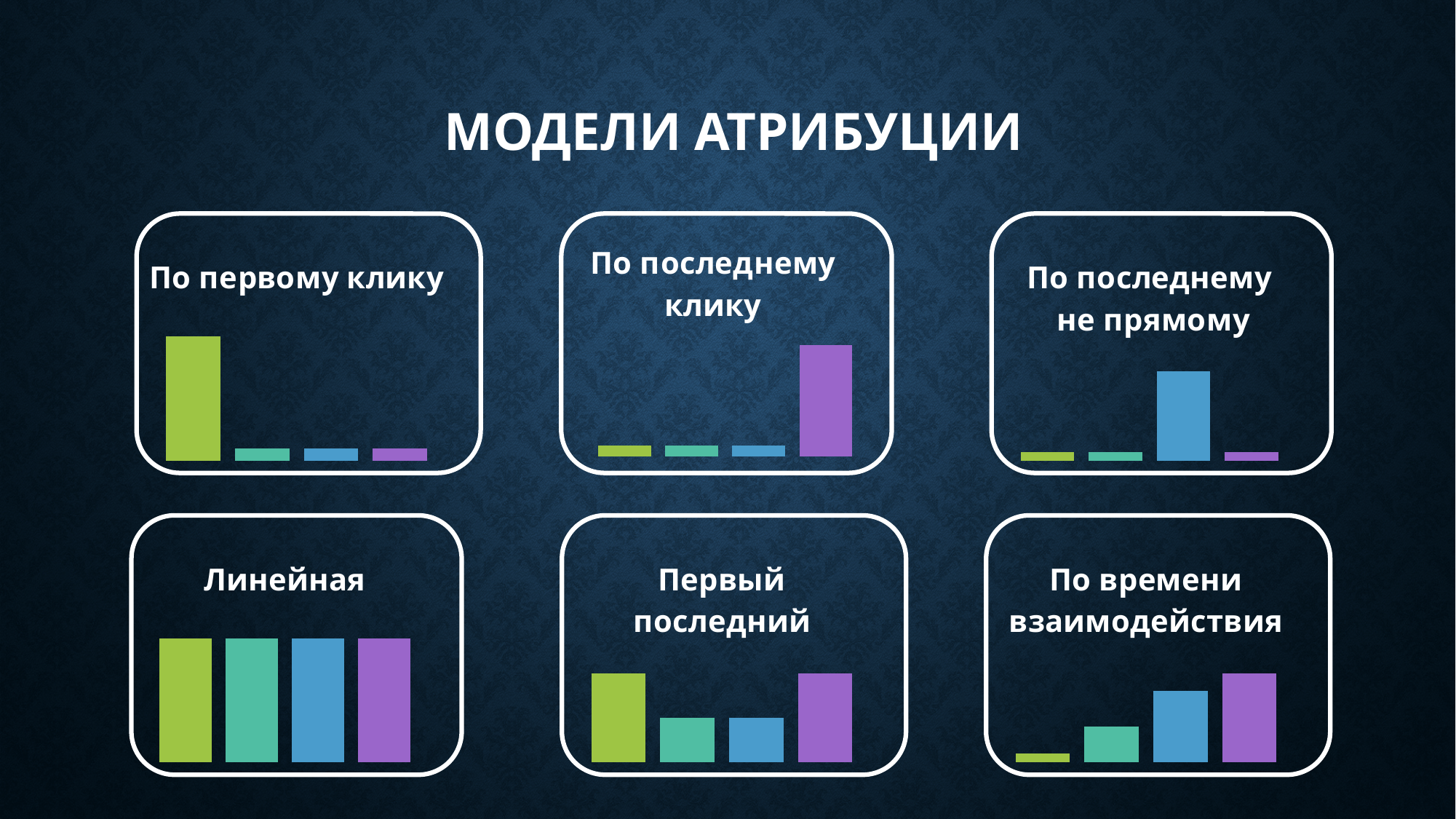
How many bars are in the "По первому клику" chart? 4 In the "Первый последний" chart, is the first bar taller or shorter than the second bar? taller What is the title of the slide? МОДЕЛИ АТРИБУЦИИ In the "По последнему клику" chart, is the purple bar taller or shorter than the green bar? taller In the "По времени взаимодействия" chart, which bar is the shortest? the first (green) bar In the "По первому клику" chart, which bar is the tallest? the first (green) bar In the "По последнему не прямому" chart, which bar is the tallest? the third (blue) bar How many bar charts are shown on the slide? 6 In the "Линейная" chart, are all four bars the same height? yes What kind of chart is shown in the "Линейная" panel? bar chart In the "По времени взаимодействия" chart, do the bars rise or fall from left to right? rise In the "По последнему клику" chart, which bar is the tallest? the last (purple) bar